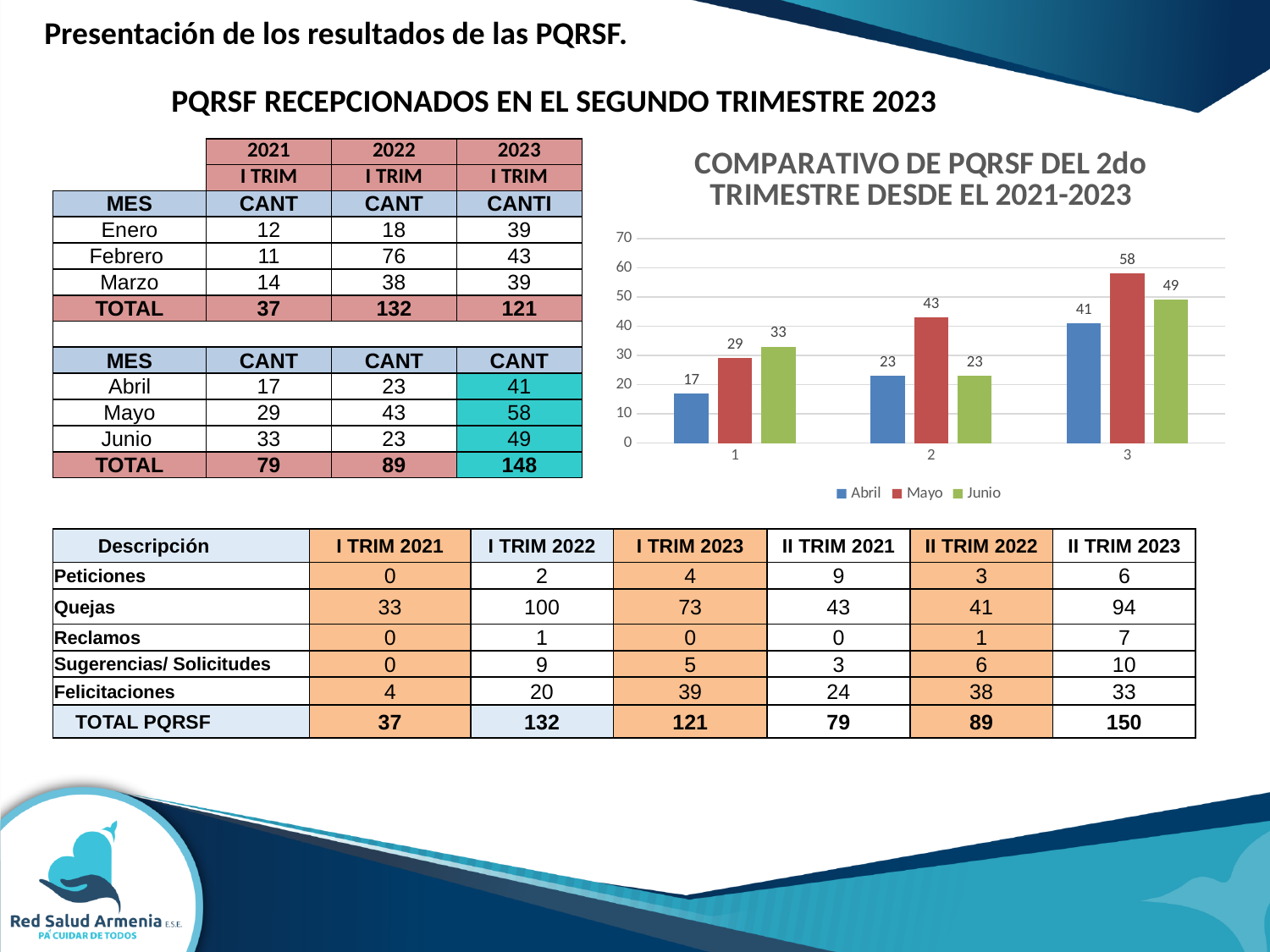
Which is larger in the chart: the Junio value for category 1 or the Junio value for category 3? Junio value for category 3 Which series has the highest value for category 3 in the chart? Mayo What is the difference between the Mayo and Abril values for category 2 in the chart? 20 How many series does the chart legend list? 3 What is the value of the Abril series for category 1 in the chart? 17 What is the title of the chart on the slide? COMPARATIVO DE PQRSF DEL 2do TRIMESTRE DESDE EL 2021-2023 What kind of chart is shown on the slide? bar chart Is the Mayo value for category 3 greater or less than 50? greater What is the value of the Junio series for category 2 in the chart? 23 How many categories are shown on the x axis of the chart? 3 Which series has the lowest value for category 1 in the chart? Abril What is the value of the Mayo series for category 3 in the chart? 58